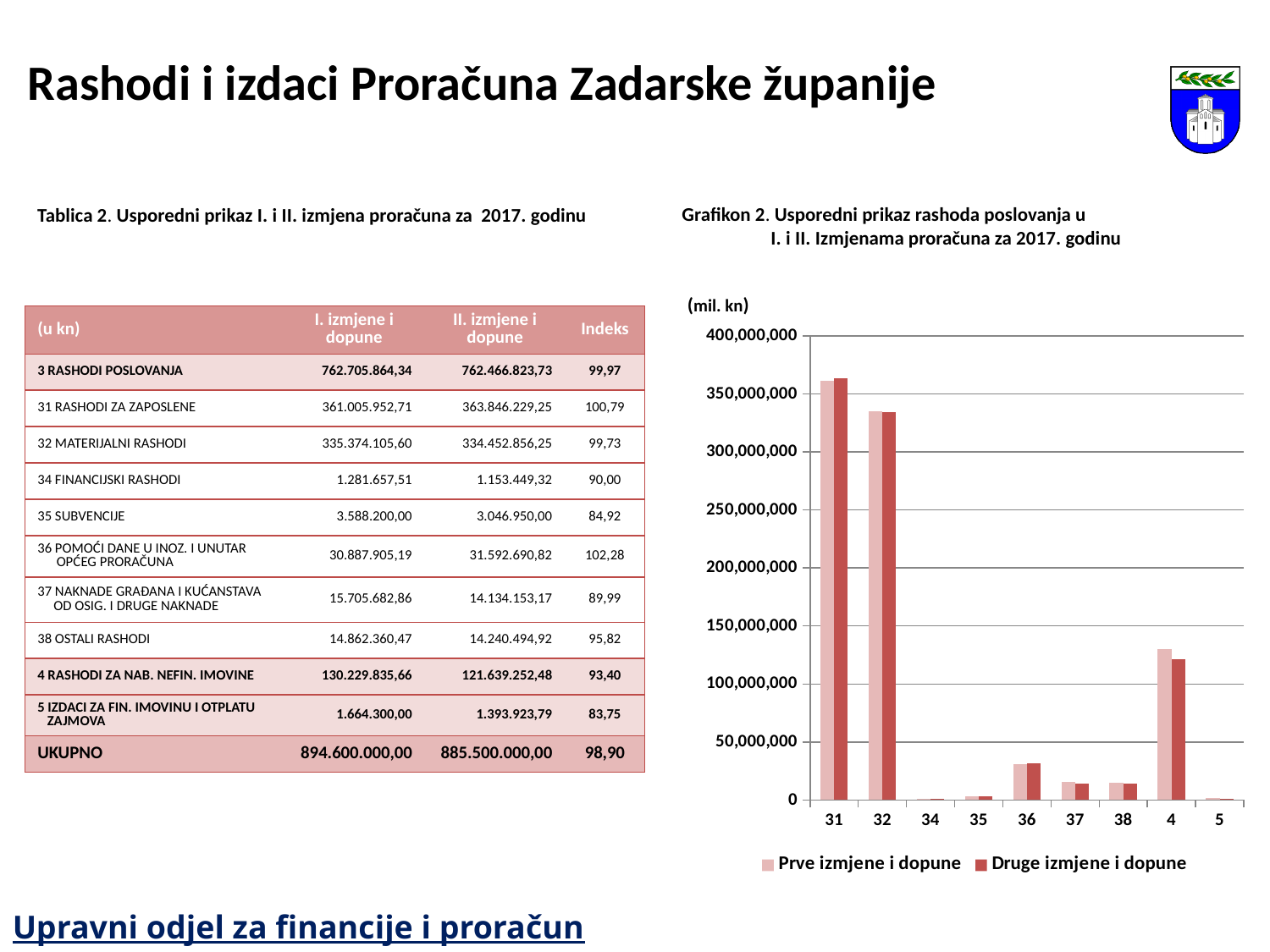
Which category has the larger bars in the chart, 4 or 36? 4 Is the value for category 4 in the Prve izmjene i dopune series greater or less than 100,000,000? greater Which category has the highest bars in the chart? 31 Is the value for category 32 in the Druge izmjene i dopune series greater or less than 350,000,000? less How many series does the chart's legend list? 2 Is the value for category 36 in the Druge izmjene i dopune series greater or less than 50,000,000? less What kind of chart is Grafikon 2? bar chart What unit is indicated above the chart's y axis? (mil. kn) How many categories are shown on the x axis of the chart? 9 Which category has the larger bars in the chart, 31 or 32? 31 What are the two series named in the chart's legend? Prve izmjene i dopune and Druge izmjene i dopune